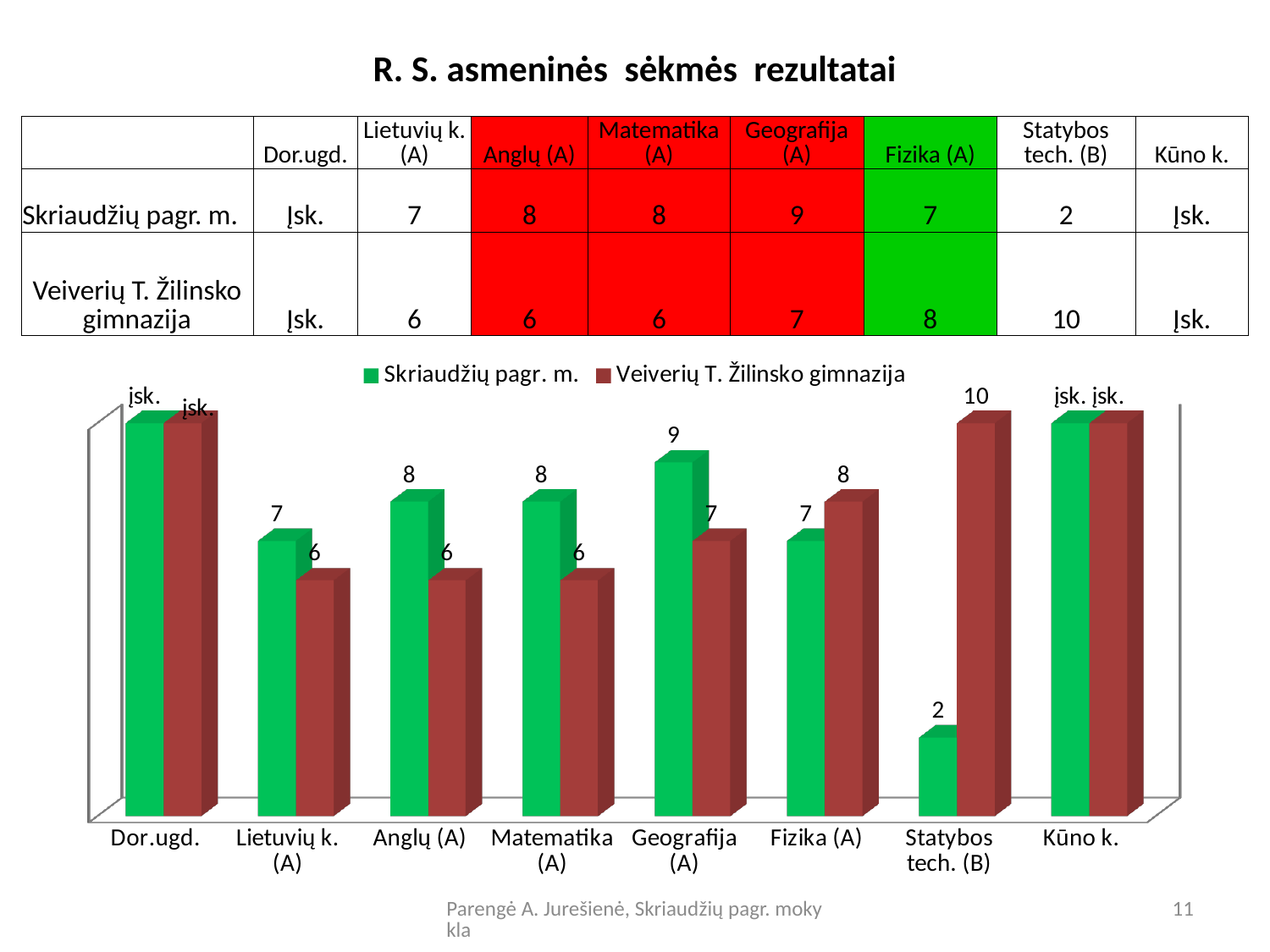
What is the difference between the two series' values in Statybos tech. (B)? 8 What kind of chart is shown on the slide? Bar chart What is the value for Skriaudžių pagr. m. in Statybos tech. (B)? 2 Among the numeric categories, which category has the lowest value for Skriaudžių pagr. m.? Statybos tech. (B) Among the numeric categories, which category has the highest value for Veiverių T. Žilinsko gimnazija? Statybos tech. (B) What is the value for Veiverių T. Žilinsko gimnazija in Statybos tech. (B)? 10 Which series has the larger value in Anglų (A)? Skriaudžių pagr. m. How many categories are shown on the x axis of the chart? 8 What is the value for Veiverių T. Žilinsko gimnazija in Fizika (A)? 8 What is the value for Skriaudžių pagr. m. in Geografija (A)? 9 How many series does the chart legend list? 2 Which series has the larger value in Fizika (A)? Veiverių T. Žilinsko gimnazija